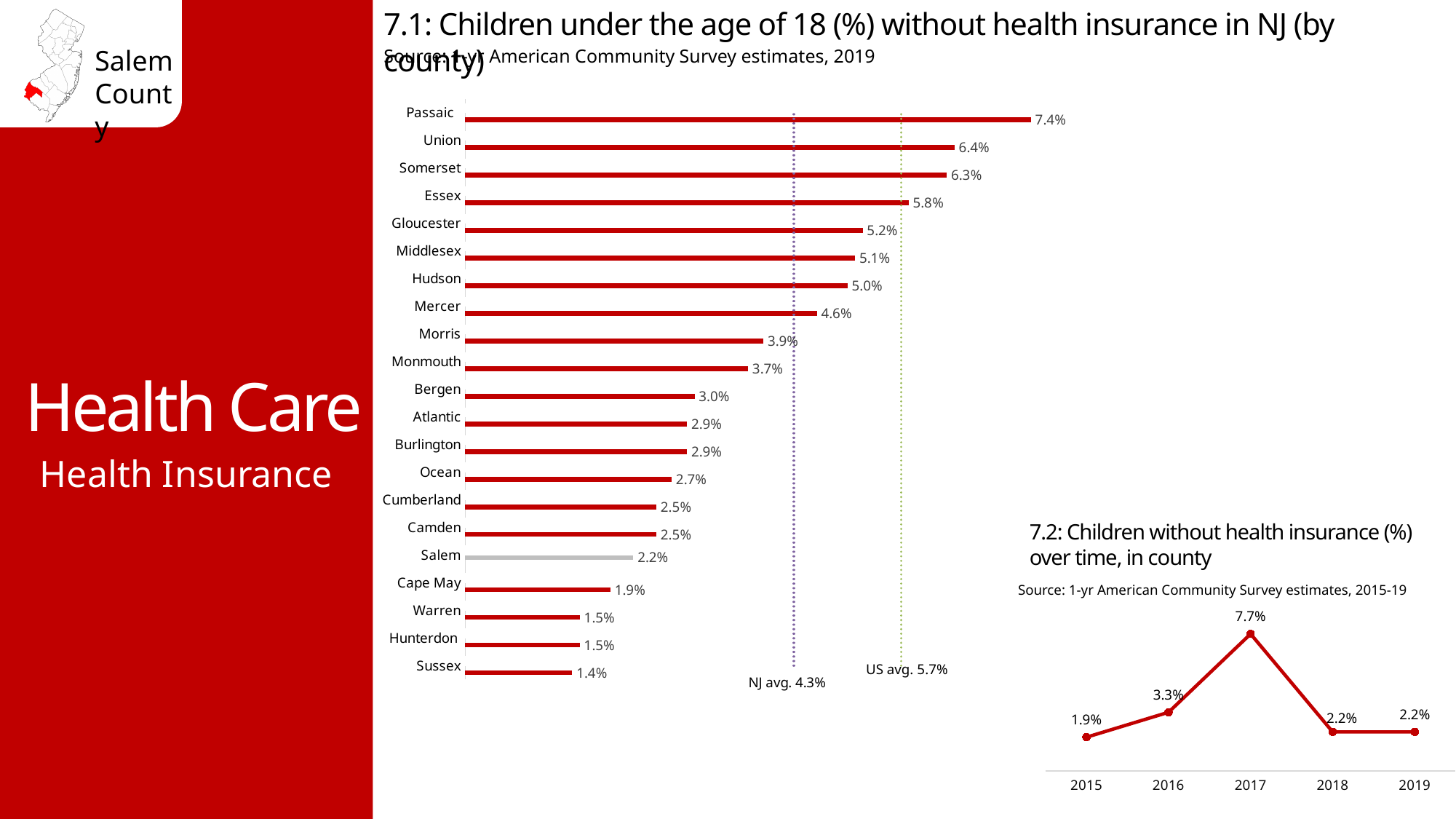
In chart 7.1, which county has a larger value, Gloucester or Mercer? Gloucester In chart 7.1, which county has the lowest percentage of children without health insurance? Sussex What kind of chart is chart 7.1? Bar chart In chart 7.1, how many counties are shown? 21 In chart 7.2 (children without health insurance over time, in county), what is the value for 2017? 7.7% In chart 7.2, which year has the lowest value? 2015 In chart 7.2, what is the difference between the values for 2017 and 2018? 5.5% In chart 7.1 (children under 18 without health insurance by county), what is the value for Salem? 2.2% In chart 7.1, which county has the highest percentage of children without health insurance? Passaic In chart 7.1, what is the difference between the values for Passaic and Sussex? 6.0% What kind of chart is chart 7.2? Line chart In chart 7.1, what is the NJ average shown by the dotted reference line? 4.3%